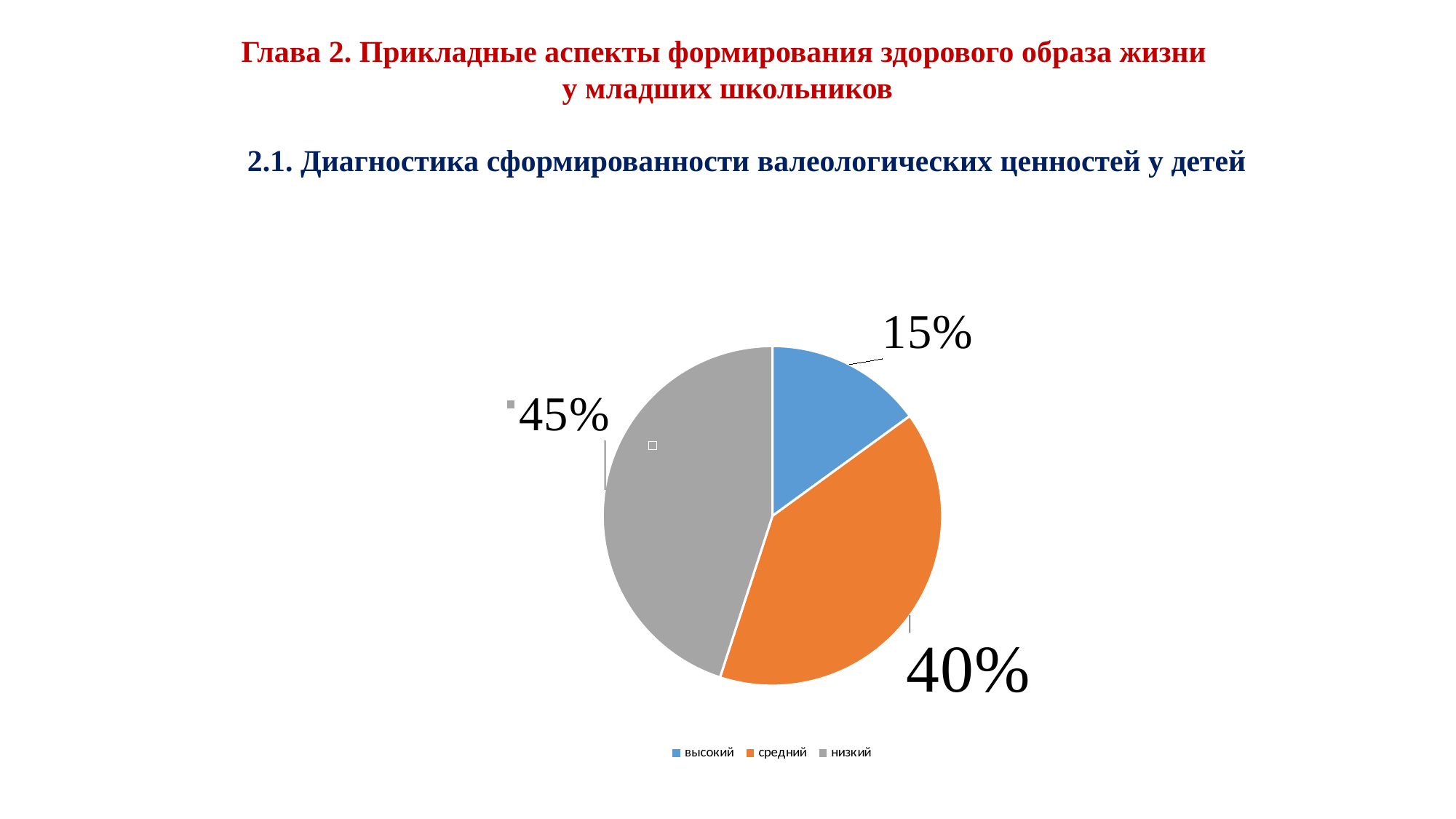
Which category has the largest slice? низкий Which is larger, the 'средний' slice or the 'высокий' slice? средний What is the difference between the 'низкий' and 'высокий' slices? 30% What are the legend entries of the chart? высокий, средний, низкий What is the value for the 'низкий' slice? 45% What is the value for the 'высокий' slice? 15% What colour is the 'средний' slice? orange What is the difference between the 'средний' and 'высокий' slices? 25% What kind of chart is shown on the slide? pie chart How many slices does the pie chart have? 3 Which category has the smallest slice? высокий What is the value for the 'средний' slice? 40%